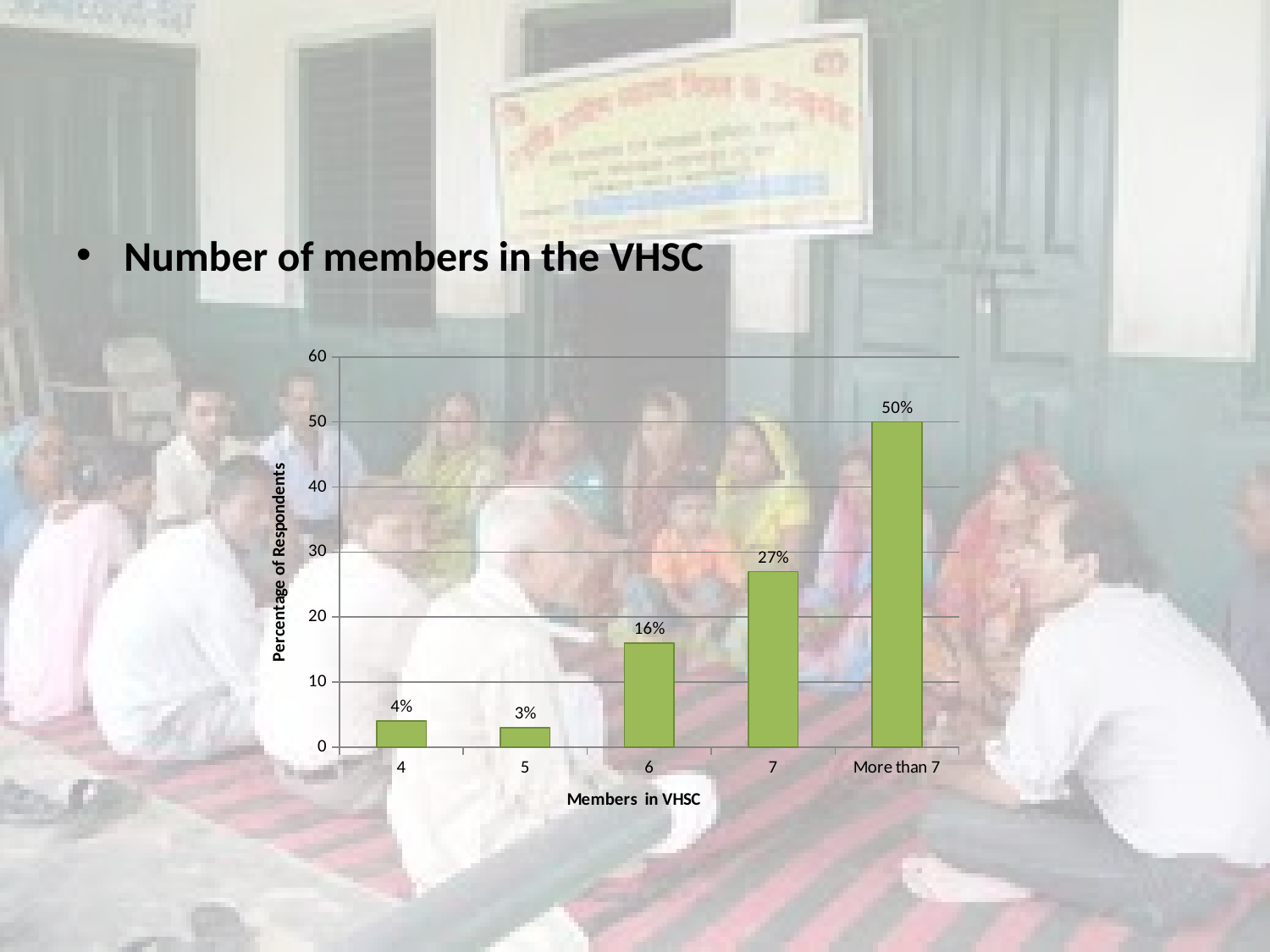
Which category of members in VHSC has the highest percentage of respondents? More than 7 Which category of members in VHSC has the lowest percentage of respondents? 5 What percentage of respondents reported 6 members in the VHSC? 16% What is the label of the y axis of the chart? Percentage of Respondents What percentage of respondents reported 4 members in the VHSC? 4% What is the difference in percentage of respondents between the 'More than 7' and '7' categories? 23% What is the label of the x axis of the chart? Members in VHSC Which has a higher percentage of respondents: 6 members or 7 members? 7 Is the value for 7 members greater or less than 30? less How many categories are shown on the x axis of the chart? 5 What kind of chart is shown on the slide? Bar chart What percentage of respondents reported more than 7 members in the VHSC? 50%